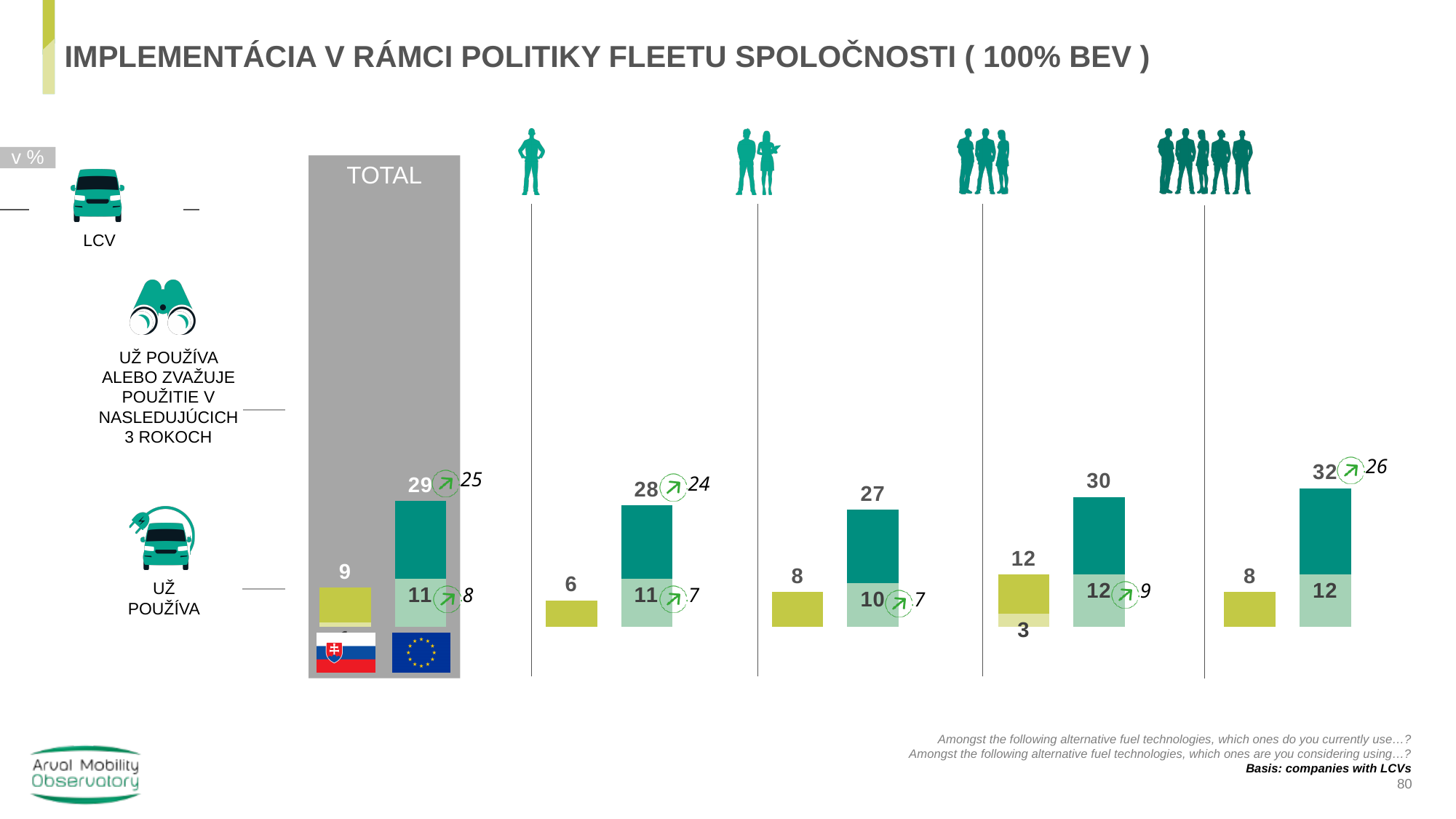
In the TOTAL column, what is the EU value for 'UŽ POUŽÍVA'? 11 How many company-size segments are shown to the right of the TOTAL column? 4 What kind of chart is shown on the slide? Bar chart In the third segment (three-person icon), which is larger: the Slovakia value or the EU value for 'UŽ POUŽÍVA ALEBO ZVAŽUJE'? EU (30 vs 12) In the TOTAL column, what is the EU value for 'UŽ POUŽÍVA ALEBO ZVAŽUJE POUŽITIE V NASLEDUJÚCICH 3 ROKOCH'? 29 In the TOTAL column, what is the Slovakia value for 'UŽ POUŽÍVA ALEBO ZVAŽUJE POUŽITIE V NASLEDUJÚCICH 3 ROKOCH'? 9 What is the previous-wave value shown in italics next to the EU TOTAL value of 29? 25 In the rightmost segment (five-person icon), what is the difference between the EU value of 32 and the Slovakia value of 8? 24 In the third segment (three-person icon), what is the Slovakia value for 'UŽ POUŽÍVA'? 3 In the TOTAL column, what is the difference between the EU values 29 and 11? 18 Among the four company-size segments to the right of TOTAL, which segment has the highest EU value for 'UŽ POUŽÍVA ALEBO ZVAŽUJE'? The rightmost segment (five-person icon), 32